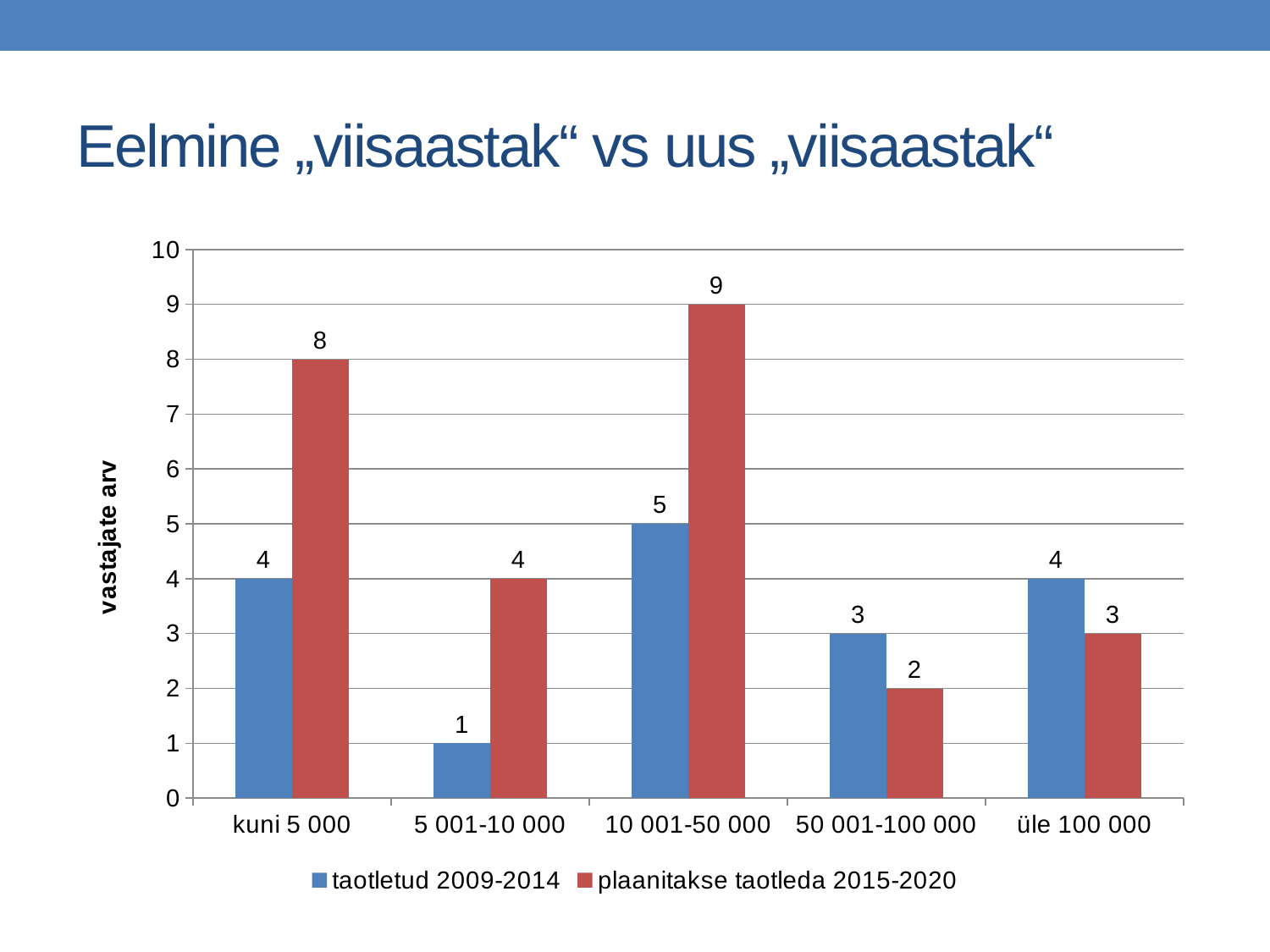
How many categories are shown on the x axis? 5 What is the value for 'plaanitakse taotleda 2015-2020' in the '50 001-100 000' category? 2 What is the value for 'taotletud 2009-2014' in the 'kuni 5 000' category? 4 What is the label of the vertical axis? vastajate arv Which category has the highest value for 'plaanitakse taotleda 2015-2020'? 10 001-50 000 How many series does the legend list? 2 What is the value for 'plaanitakse taotleda 2015-2020' in the '10 001-50 000' category? 9 What is the value for 'taotletud 2009-2014' in the '5 001-10 000' category? 1 In the 'üle 100 000' category, which series has the larger value, 'taotletud 2009-2014' or 'plaanitakse taotleda 2015-2020'? taotletud 2009-2014 Which category has the lowest value for 'taotletud 2009-2014'? 5 001-10 000 What is the difference between 'plaanitakse taotleda 2015-2020' and 'taotletud 2009-2014' in the 'kuni 5 000' category? 4 What kind of chart is shown on the slide? bar chart